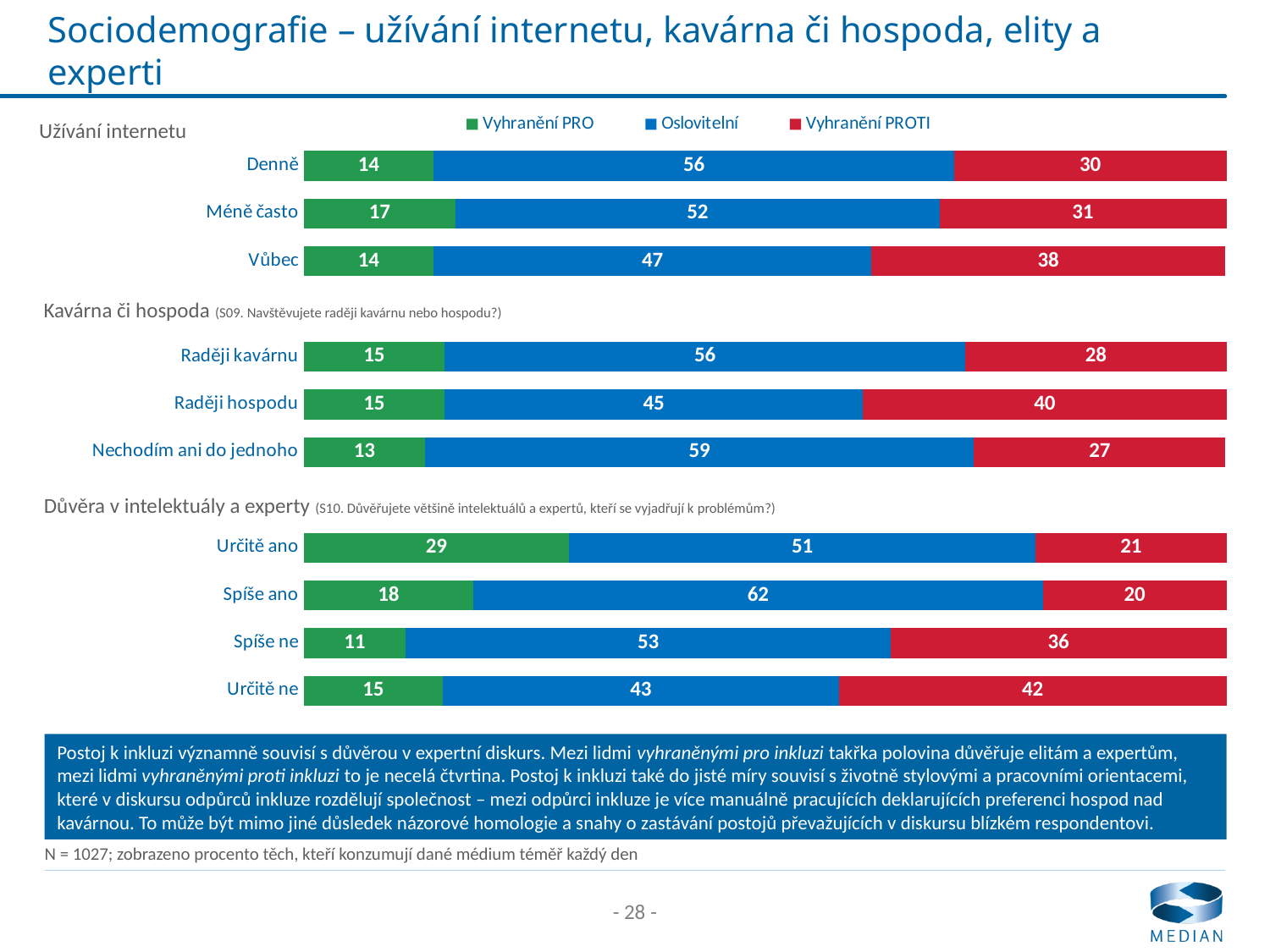
In the 'Kavárna či hospoda' chart, which category has the highest 'Oslovitelní' value? Nechodím ani do jednoho In the 'Užívání internetu' chart, what is the value of 'Oslovitelní' for 'Denně'? 56 In the 'Užívání internetu' chart, which category has the highest 'Vyhranění PROTI' value? Vůbec In the 'Kavárna či hospoda' chart, which is larger: the 'Vyhranění PROTI' value for 'Raději kavárnu' or for 'Raději hospodu'? Raději hospodu In the 'Důvěra v intelektuály a experty' chart, what is the 'Vyhranění PRO' value for 'Určitě ano'? 29 How many series does the legend at the top of the slide list? 3 In the 'Užívání internetu' chart, what is the difference between the 'Vyhranění PRO' values for 'Méně často' and 'Denně'? 3 In the 'Důvěra v intelektuály a experty' chart, which category has the lowest 'Vyhranění PRO' value? Spíše ne In the 'Kavárna či hospoda' chart, what is the 'Vyhranění PROTI' value for 'Raději hospodu'? 40 In the 'Důvěra v intelektuály a experty' chart, what is the difference between the 'Vyhranění PROTI' values for 'Určitě ne' and 'Určitě ano'? 21 How many categories does the 'Důvěra v intelektuály a experty' chart show? 4 What kind of chart is the 'Užívání internetu' chart? Stacked bar chart